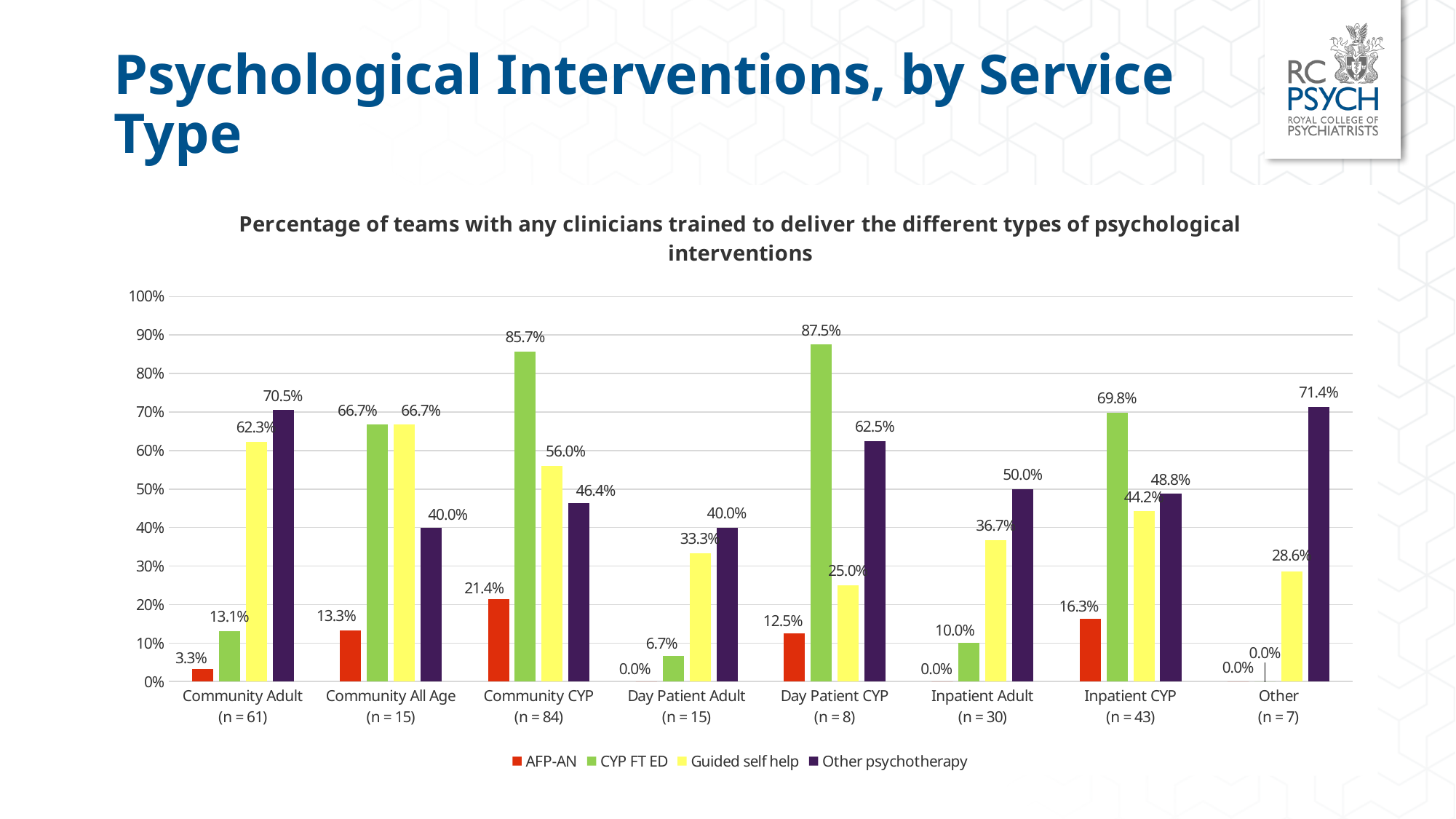
Which colour represents the AFP-AN series in the chart? Red What is the value for Guided self help for Inpatient Adult teams? 36.7% Is the value for CYP FT ED in Inpatient CYP greater or less than 60%? greater What percentage of Community CYP teams have clinicians trained to deliver CYP FT ED? 85.7% Which service type has the lowest value for Guided self help? Day Patient CYP How many service types are shown on the x axis? 8 How many series does the legend list? 4 What is the difference between the Other psychotherapy and Guided self help values for Community Adult teams? 8.2% What kind of chart is shown on the slide? Bar chart What is the value for Other psychotherapy in the Other (n = 7) service type? 71.4% For Inpatient CYP teams, which is larger: the Guided self help value or the Other psychotherapy value? Other psychotherapy Which service type has the highest value for CYP FT ED? Day Patient CYP